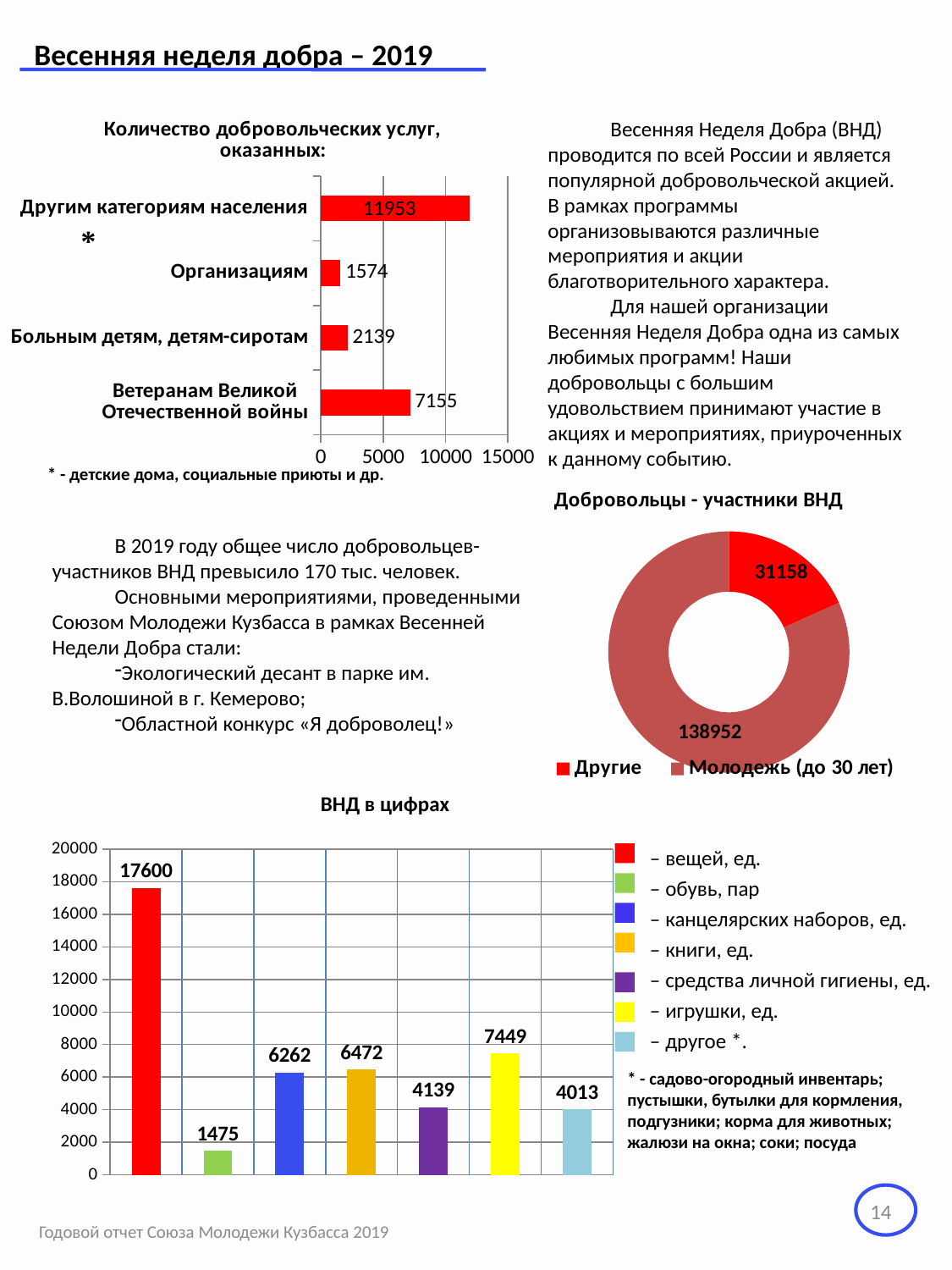
In the chart 'Количество добровольческих услуг, оказанных:', what is the difference between the values for 'Другим категориям населения' and 'Ветеранам Великой Отечественной войны'? 4798 In the chart 'ВНД в цифрах', how many entries does the legend list? 7 In the chart 'ВНД в цифрах', what colour is the bar for 'вещей, ед.'? Red In the chart 'Добровольцы - участники ВНД', what is the value for 'Молодежь (до 30 лет)'? 138952 In the chart 'ВНД в цифрах', which category has the lowest value? обувь, пар In the chart 'Добровольцы - участники ВНД', what is the total of the two segments? 170110 What kind of chart is 'Добровольцы - участники ВНД'? Donut (pie) chart In the chart 'Количество добровольческих услуг, оказанных:', what is the value for 'Организациям'? 1574 In the chart 'ВНД в цифрах', what is the value for 'игрушки, ед.'? 7449 In the chart 'ВНД в цифрах', which is larger: 'книги, ед.' or 'канцелярских наборов, ед.'? книги, ед. In the chart 'Количество добровольческих услуг, оказанных:', how many categories are shown? 4 In the chart 'Количество добровольческих услуг, оказанных:', which category has the highest value? Другим категориям населения